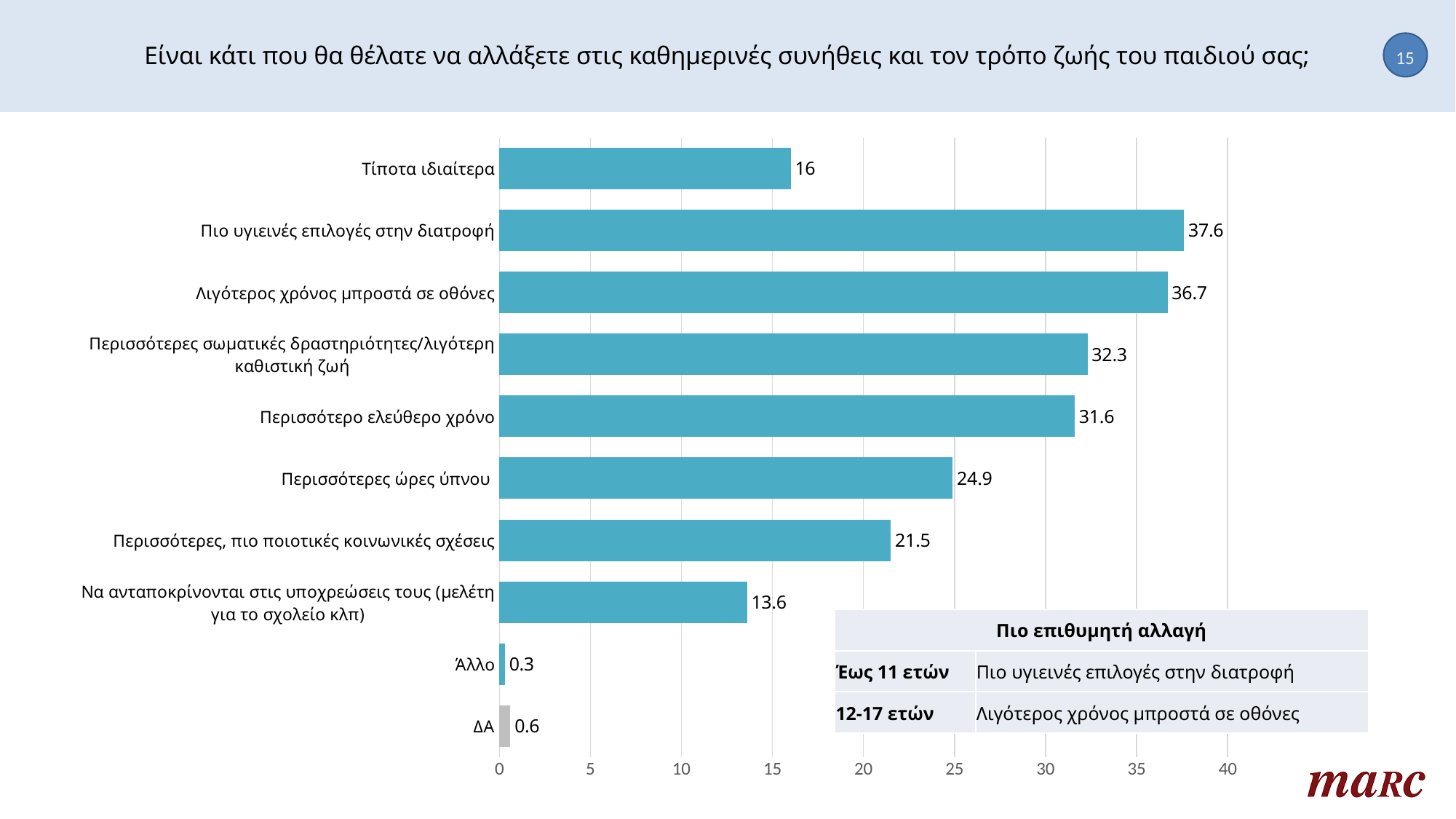
Which category has the lowest value? Άλλο Is the value for "Τίποτα ιδιαίτερα" greater or less than 20? less What is the difference between the values for "Περισσότερες ώρες ύπνου" and "Περισσότερες, πιο ποιοτικές κοινωνικές σχέσεις"? 3.4 How many categories are shown in the chart? 10 What is the value for "Περισσότερες ώρες ύπνου"? 24.9 What is the value for "Να ανταποκρίνονται στις υποχρεώσεις τους (μελέτη για το σχολείο κλπ)"? 13.6 Which is larger, the value for "Περισσότερες σωματικές δραστηριότητες/λιγότερη καθιστική ζωή" or the value for "Περισσότερο ελεύθερο χρόνο"? Περισσότερες σωματικές δραστηριότητες/λιγότερη καθιστική ζωή What kind of chart is shown on the slide? bar chart What is the value for "Πιο υγιεινές επιλογές στην διατροφή"? 37.6 According to the table on the slide, what is the most desired change (Πιο επιθυμητή αλλαγή) for the 12-17 ετών group? Λιγότερος χρόνος μπροστά σε οθόνες What is the difference between the values for "Πιο υγιεινές επιλογές στην διατροφή" and "Λιγότερος χρόνος μπροστά σε οθόνες"? 0.9 Which category has the highest value? Πιο υγιεινές επιλογές στην διατροφή